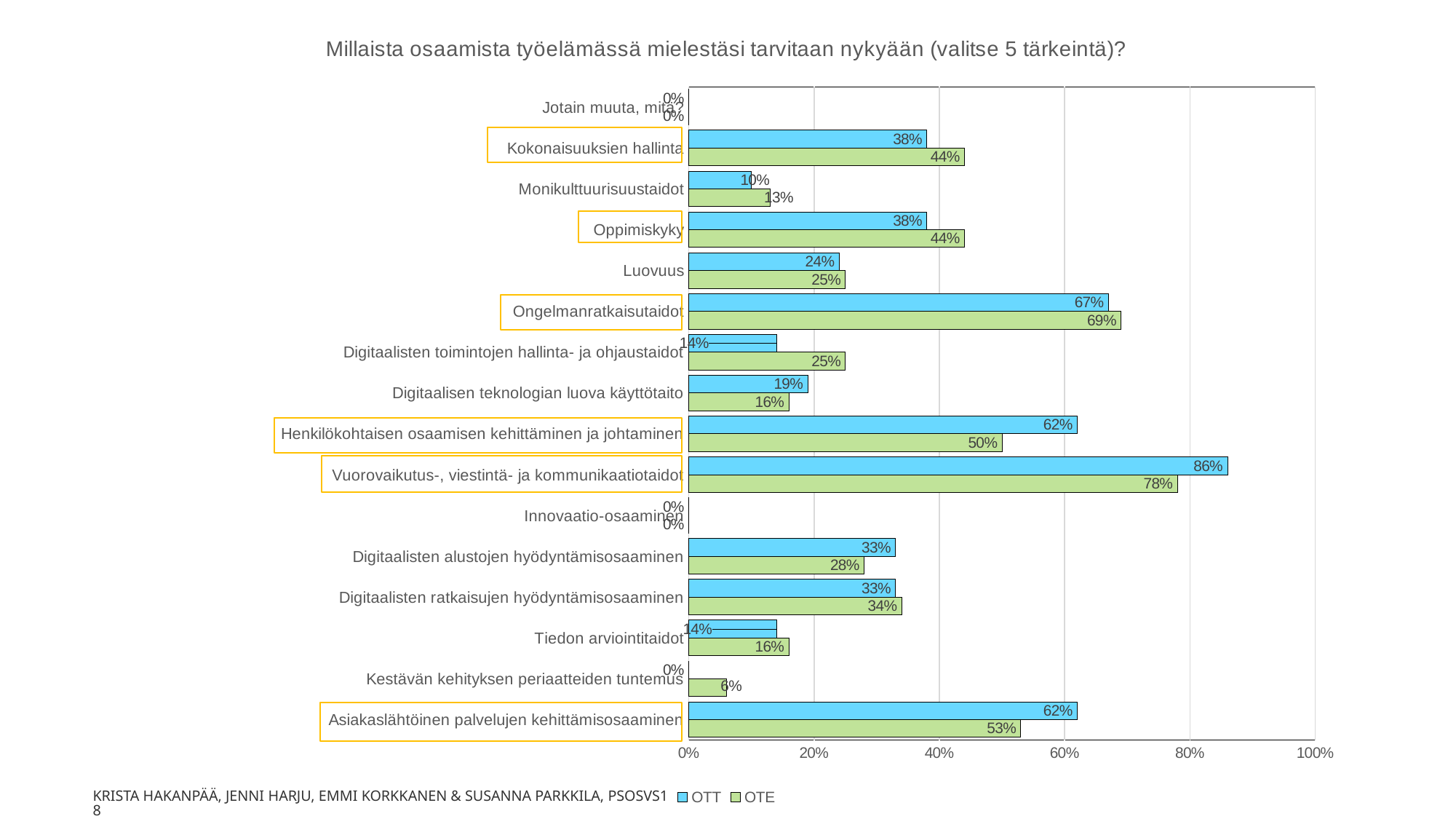
Which category has the highest OTE value? Vuorovaikutus-, viestintä- ja kommunikaatiotaidot What is the difference between the OTT and OTE values for Henkilökohtaisen osaamisen kehittäminen ja johtaminen? 12% What is the OTT value for Henkilökohtaisen osaamisen kehittäminen ja johtaminen? 62% What is the difference between the OTE and OTT values for Digitaalisten toimintojen hallinta- ja ohjaustaidot? 11% For Asiakaslähtöinen palvelujen kehittämisosaaminen, which series has the larger value, OTT or OTE? OTT How many categories are shown on the chart? 16 How many series does the legend list? 2 What is the OTE value for Kestävän kehityksen periaatteiden tuntemus? 6% What kind of chart is shown on the slide? Bar chart Which category has the highest OTT value? Vuorovaikutus-, viestintä- ja kommunikaatiotaidot What is the OTT value for Vuorovaikutus-, viestintä- ja kommunikaatiotaidot? 86% What is the OTE value for Ongelmanratkaisutaidot? 69%